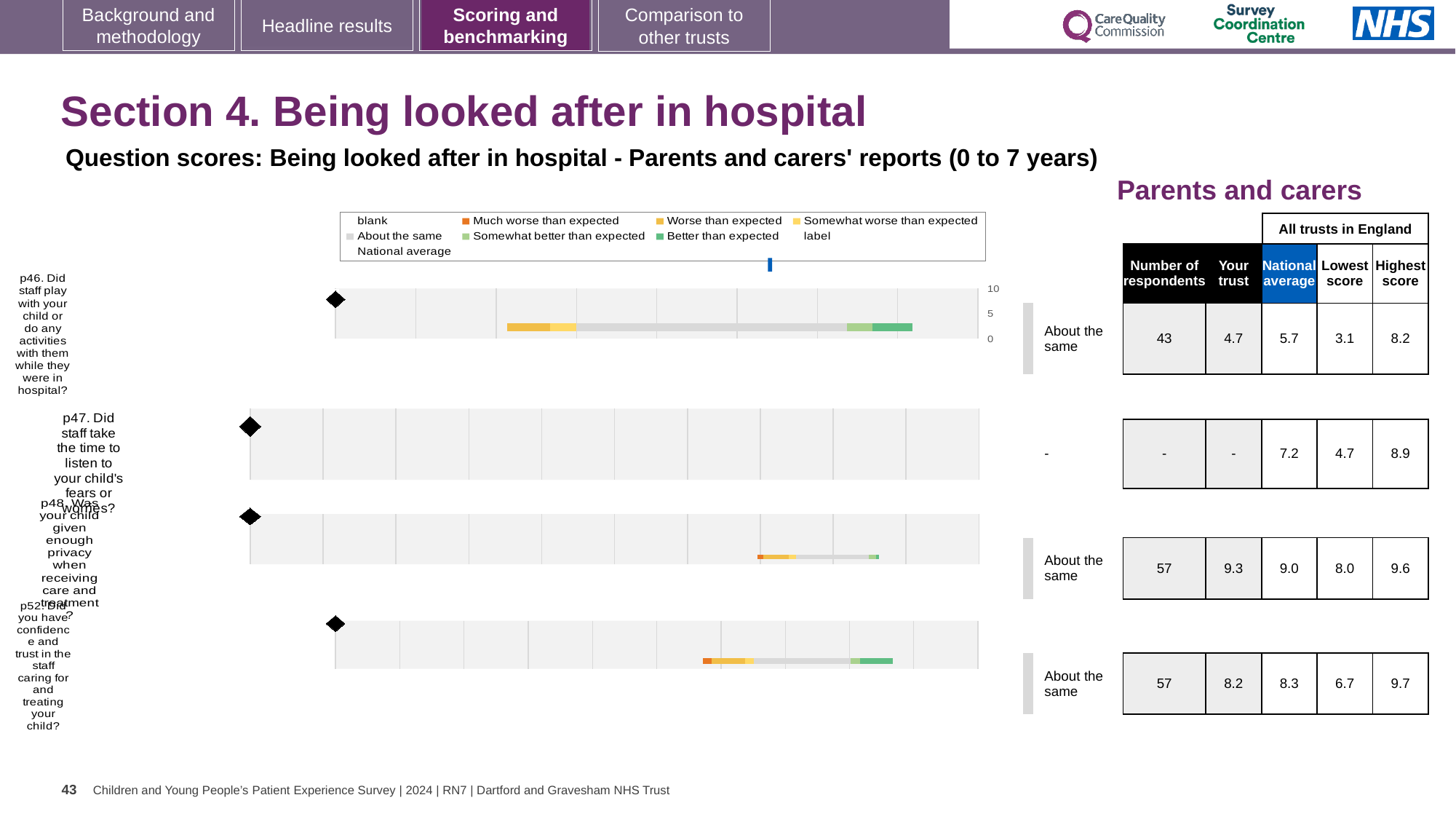
What is the national average score for p48 (Was your child given enough privacy when receiving care and treatment?)? 9.0 How many questions are plotted on the chart? 4 For p52, which is larger: the 'Your trust' score or the national average? National average What is the 'Your trust' score for p46 (Did staff play with your child or do any activities with them while they were in hospital?)? 4.7 Which question has the highest 'Your trust' score? p48 What is the lowest score among all trusts in England for p47 (Did staff take the time to listen to your child's fears or worries?)? 4.7 Which question has the lowest national average score? p46 How many respondents answered p48? 57 What is the difference between the national average and the 'Your trust' score for p46? 1.0 What is the highest score among all trusts in England for p52 (Did you have confidence and trust in the staff caring for and treating your child?)? 9.7 What benchmark category is shown for p46? About the same What kind of chart is shown on the slide? Bar chart